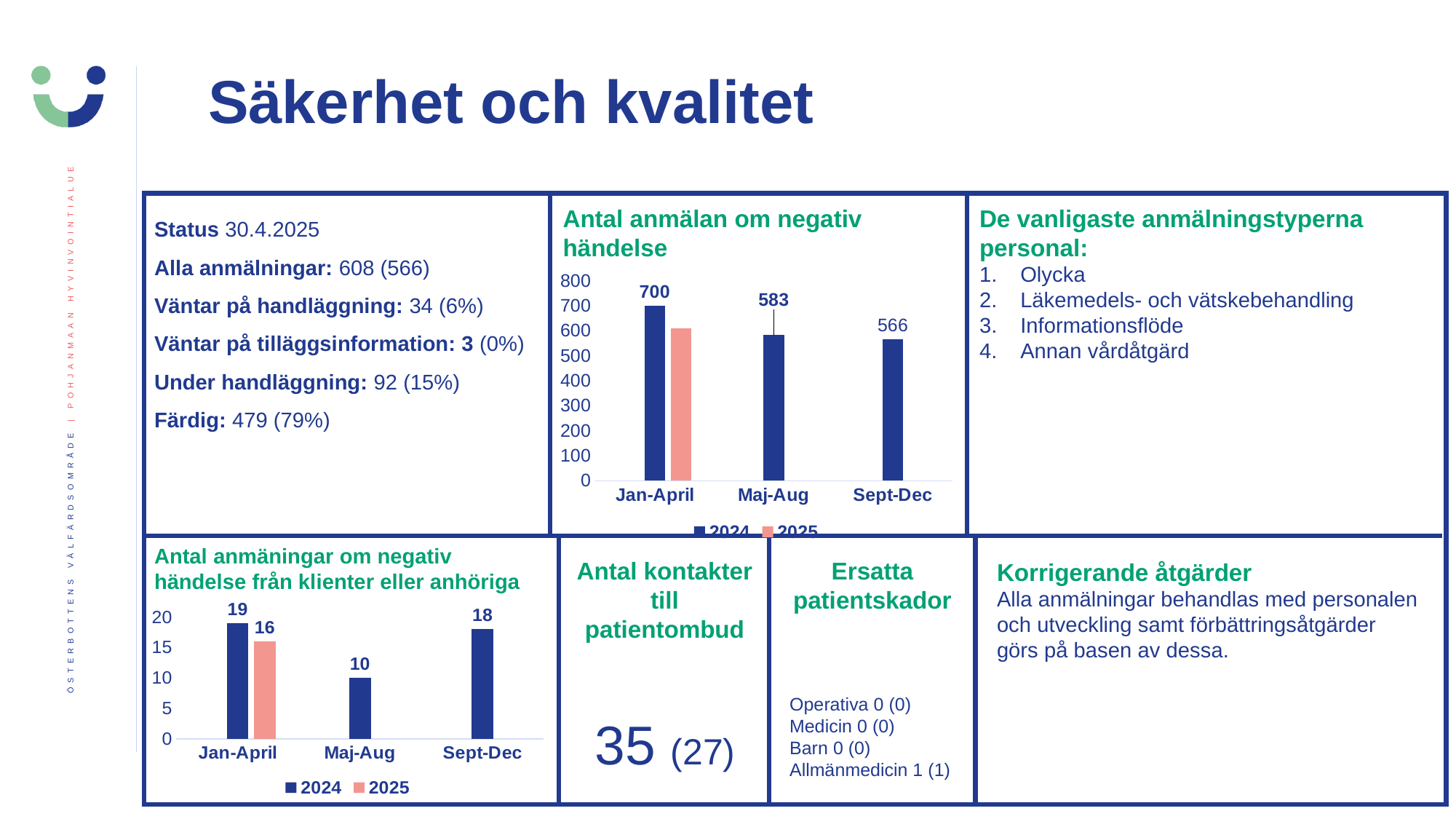
In the chart 'Antal anmäningar om negativ händelse från klienter eller anhöriga', what is the 2024 value for Maj-Aug? 10 What kind of chart is 'Antal anmäningar om negativ händelse från klienter eller anhöriga'? Bar chart In the chart 'Antal anmälan om negativ händelse', is the 2025 value for Jan-April greater or less than 500? greater In the chart 'Antal anmäningar om negativ händelse från klienter eller anhöriga', what is the 2025 value for Jan-April? 16 In the chart 'Antal anmäningar om negativ händelse från klienter eller anhöriga', which is larger for Jan-April: the 2024 value or the 2025 value? 2024 In the chart 'Antal anmälan om negativ händelse', what is the difference between the 2024 values for Jan-April and Maj-Aug? 117 In the chart 'Antal anmälan om negativ händelse', what is the 2024 value for Sept-Dec? 566 In the chart 'Antal anmälan om negativ händelse', what is the 2024 value for Jan-April? 700 In the chart 'Antal anmälan om negativ händelse', which period has the highest 2024 value? Jan-April In the chart 'Antal anmäningar om negativ händelse från klienter eller anhöriga', which period has the lowest 2024 value? Maj-Aug In the chart 'Antal anmälan om negativ händelse', how many series does the legend list? 2 In the chart 'Antal anmäningar om negativ händelse från klienter eller anhöriga', how many periods are shown on the x axis? 3